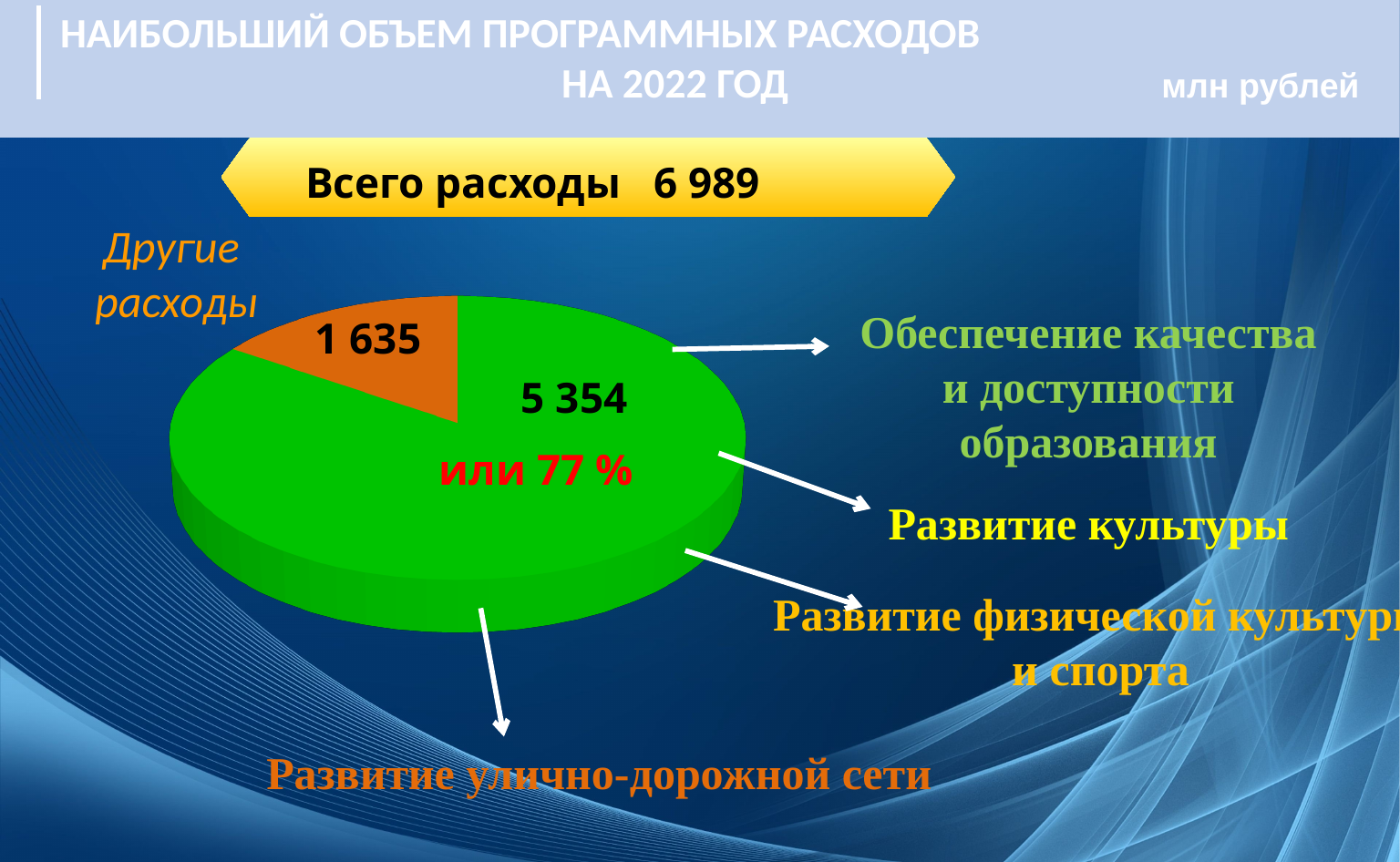
Which slice of the pie chart is the largest? the green slice (5 354) What total expenditure ("Всего расходы") is shown on the slide? 6 989 What kind of chart is shown on the slide? pie chart Which is larger: the green slice or the "Другие расходы" slice? the green slice Which slice of the pie chart is the smallest? Другие расходы (1 635) What is the value of the slice labelled "Другие расходы"? 1 635 What colour is the slice labelled "Другие расходы"? orange What is the difference between the green slice (5 354) and the "Другие расходы" slice (1 635)? 3 719 In what units are the values on the slide given? млн рублей What share of the pie does the green slice represent, as printed on the slide? 77 % How many slices does the pie chart have? 2 What is the value of the green slice of the pie chart? 5 354